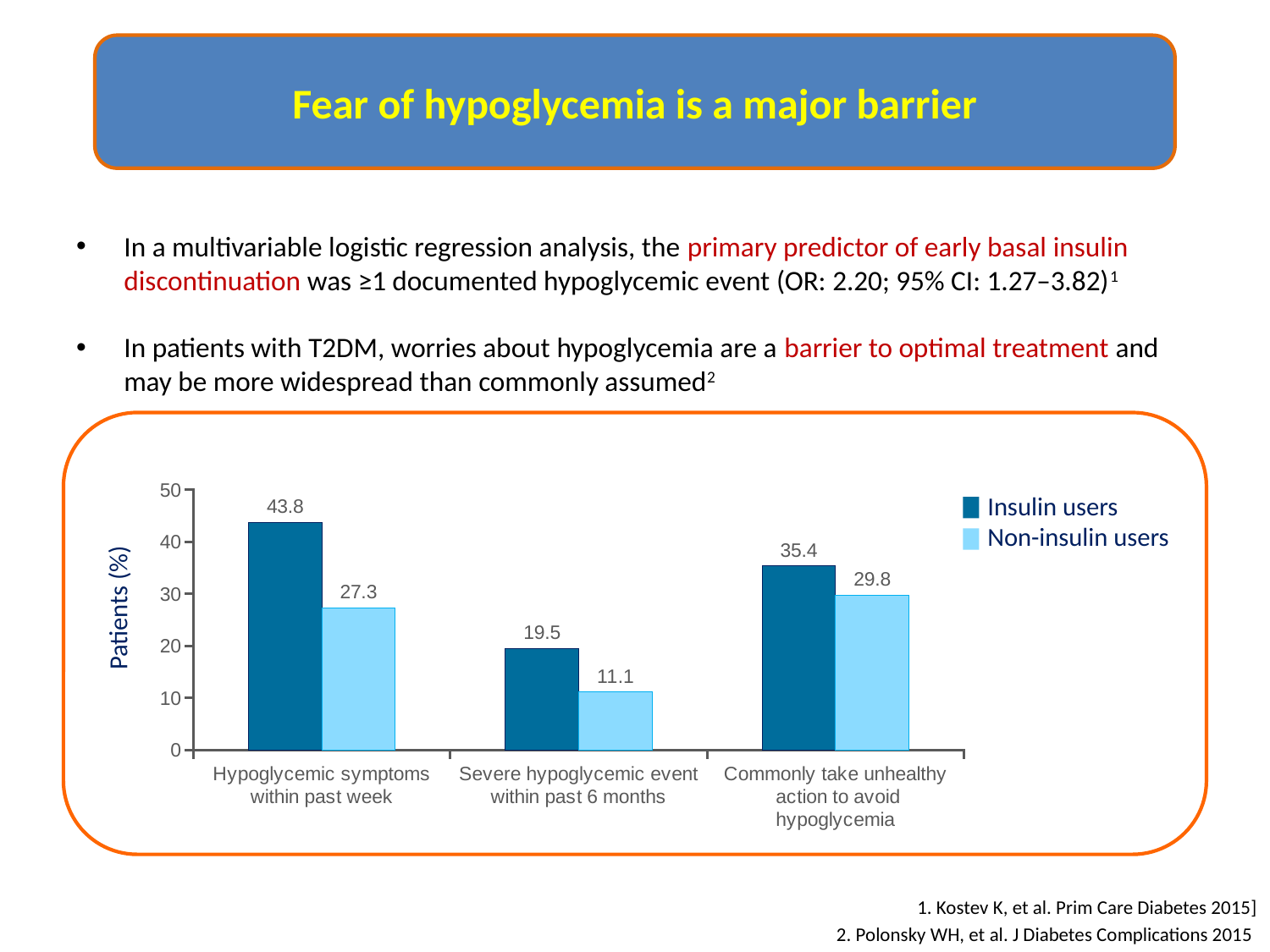
What is the difference between insulin users and non-insulin users for 'Commonly take unhealthy action to avoid hypoglycemia'? 5.6 Which category has the lowest value for non-insulin users? Severe hypoglycemic event within past 6 months How many categories are shown on the x axis of the chart? 3 Which category has the highest value for insulin users? Hypoglycemic symptoms within past week What is the value for non-insulin users for 'Severe hypoglycemic event within past 6 months'? 11.1 What type of chart is shown on the slide? Bar chart What percentage of insulin users reported hypoglycemic symptoms within the past week? 43.8 What is the value for non-insulin users for 'Commonly take unhealthy action to avoid hypoglycemia'? 29.8 How many series does the chart legend list? 2 For 'Severe hypoglycemic event within past 6 months', which group has the larger value: insulin users or non-insulin users? Insulin users What is the difference between insulin users and non-insulin users for 'Hypoglycemic symptoms within past week'? 16.5 What is the label of the y axis of the chart? Patients (%)